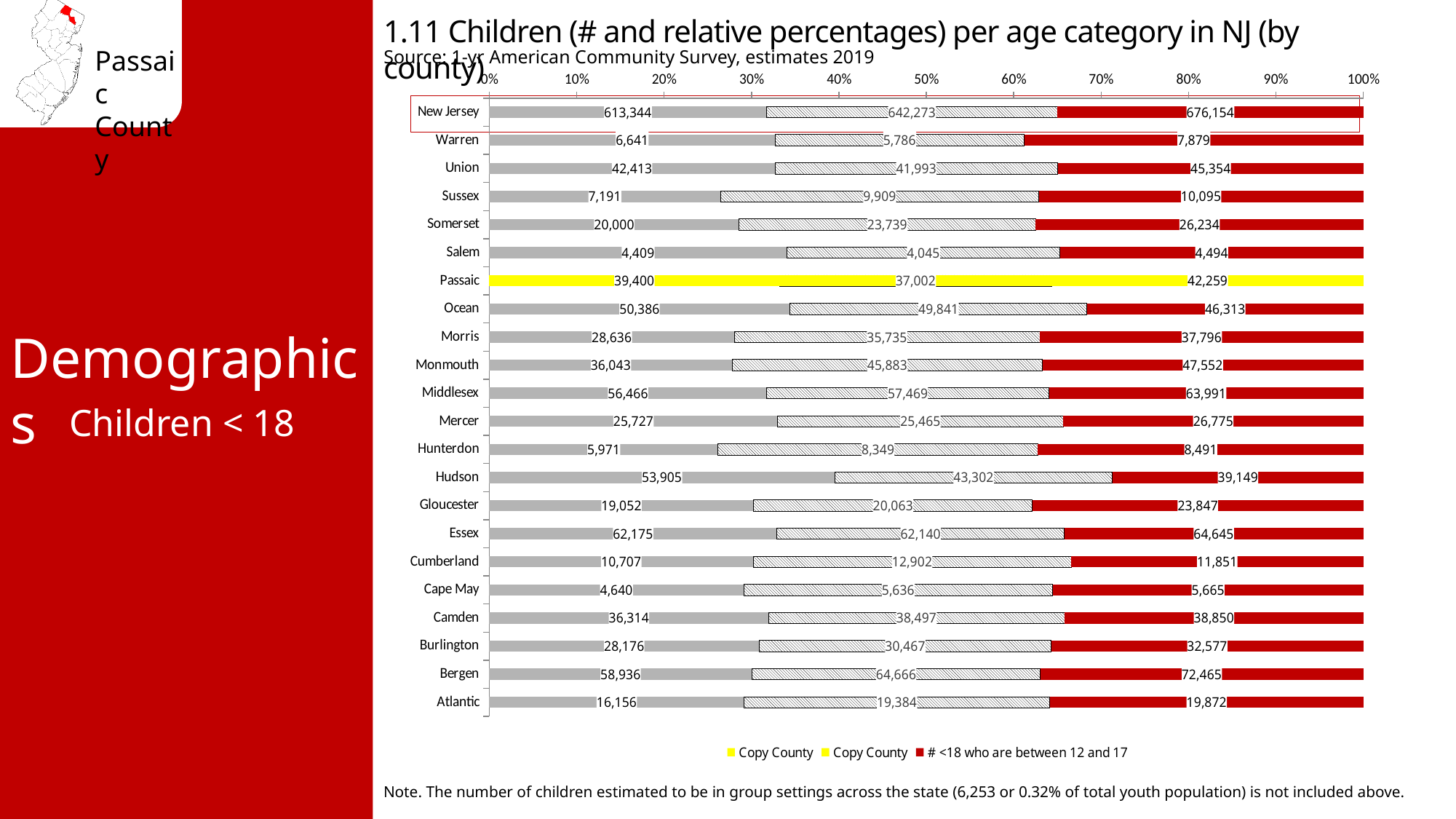
What value is printed on the leftmost (grey) segment of the Hudson bar? 53,905 What value is printed on the middle (hatched) segment of the Ocean bar? 49,841 How many rows (categories) are plotted on the chart? 22 What kind of chart is shown on the slide? Stacked bar chart Excluding the New Jersey total row, which county has the highest value for '# <18 who are between 12 and 17'? Bergen How many series does the legend list? 3 Which county has the lowest value for '# <18 who are between 12 and 17'? Salem What is the value for Passaic in the series '# <18 who are between 12 and 17'? 42,259 What is the value for New Jersey in the series '# <18 who are between 12 and 17'? 676,154 For Passaic, what is the difference between the '# <18 who are between 12 and 17' value and the middle segment value? 5,257 What is the total of the three values printed on the Passaic bar? 118,661 Which is larger for '# <18 who are between 12 and 17': Bergen or Essex? Bergen